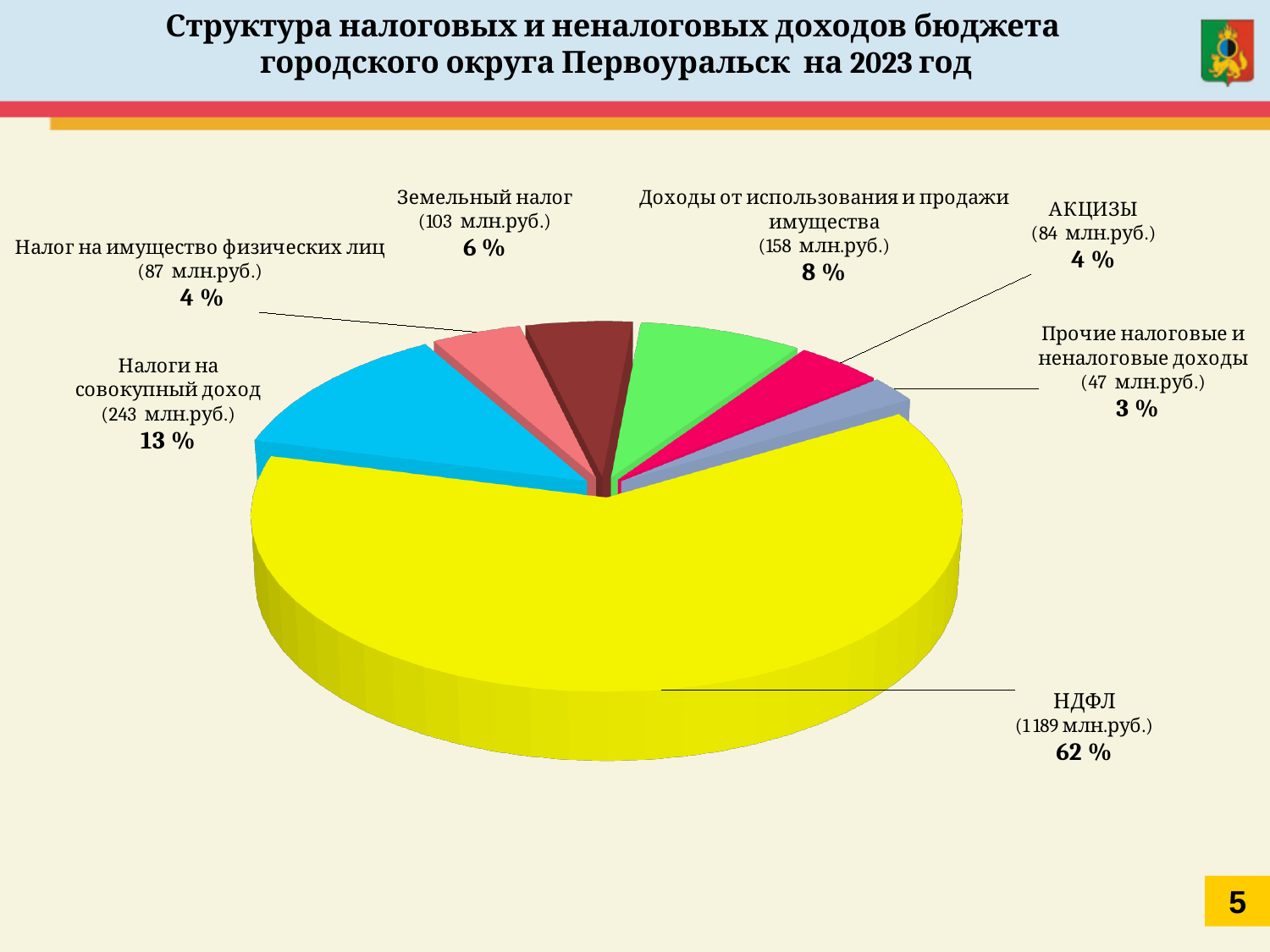
What is the difference in млн.руб. between Налоги на совокупный доход and Земельный налог? 140 млн.руб. Which is larger: АКЦИЗЫ or Налог на имущество физических лиц (in млн.руб.)? Налог на имущество физических лиц What is the value shown for Налоги на совокупный доход? 243 млн.руб. How many slices does the pie chart have? 7 What percentage is shown for Земельный налог? 6 % Which category has the smallest slice of the pie? Прочие налоговые и неналоговые доходы What kind of chart is shown on the slide? Pie chart What colour is the НДФЛ slice? Yellow What is the value shown for НДФЛ? 1 189 млн.руб. Which category has the largest slice of the pie? НДФЛ What share of the pie does НДФЛ represent? 62 % What is the value shown for Доходы от использования и продажи имущества? 158 млн.руб.